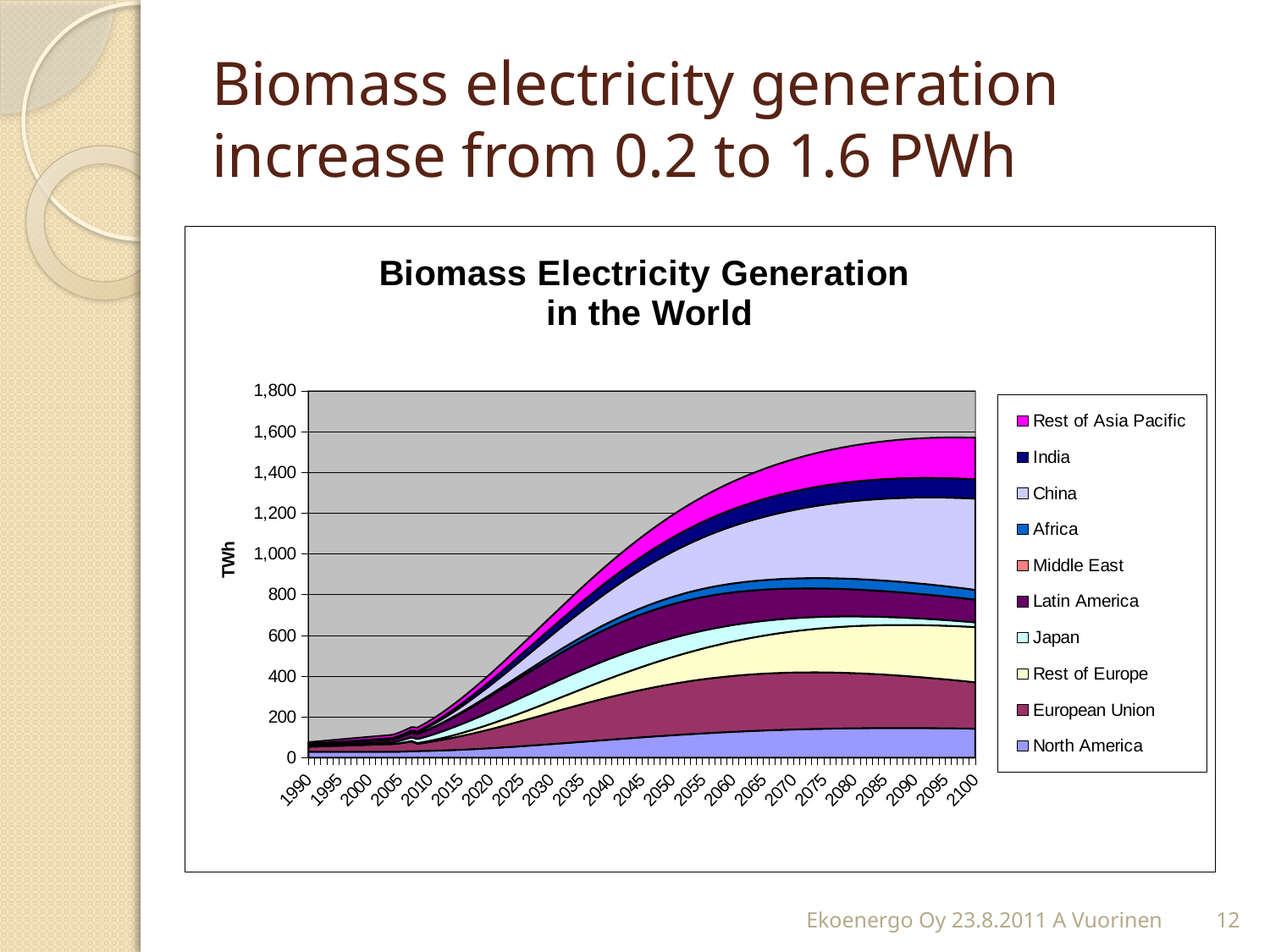
Is the total value for 2070 greater or less than 1,200? greater Is the total value for 1990 greater or less than 200? less Is the total value for 2050 greater or less than 1,000? greater Does total biomass electricity generation rise or fall from 1990 to 2100? rise What is the title of the chart? Biomass Electricity Generation in the World What unit is shown on the y-axis label? TWh How many year labels are shown on the x axis? 23 How many series does the legend list? 10 What kind of chart is shown on the slide? stacked area chart What is the highest value shown on the y axis? 1,800